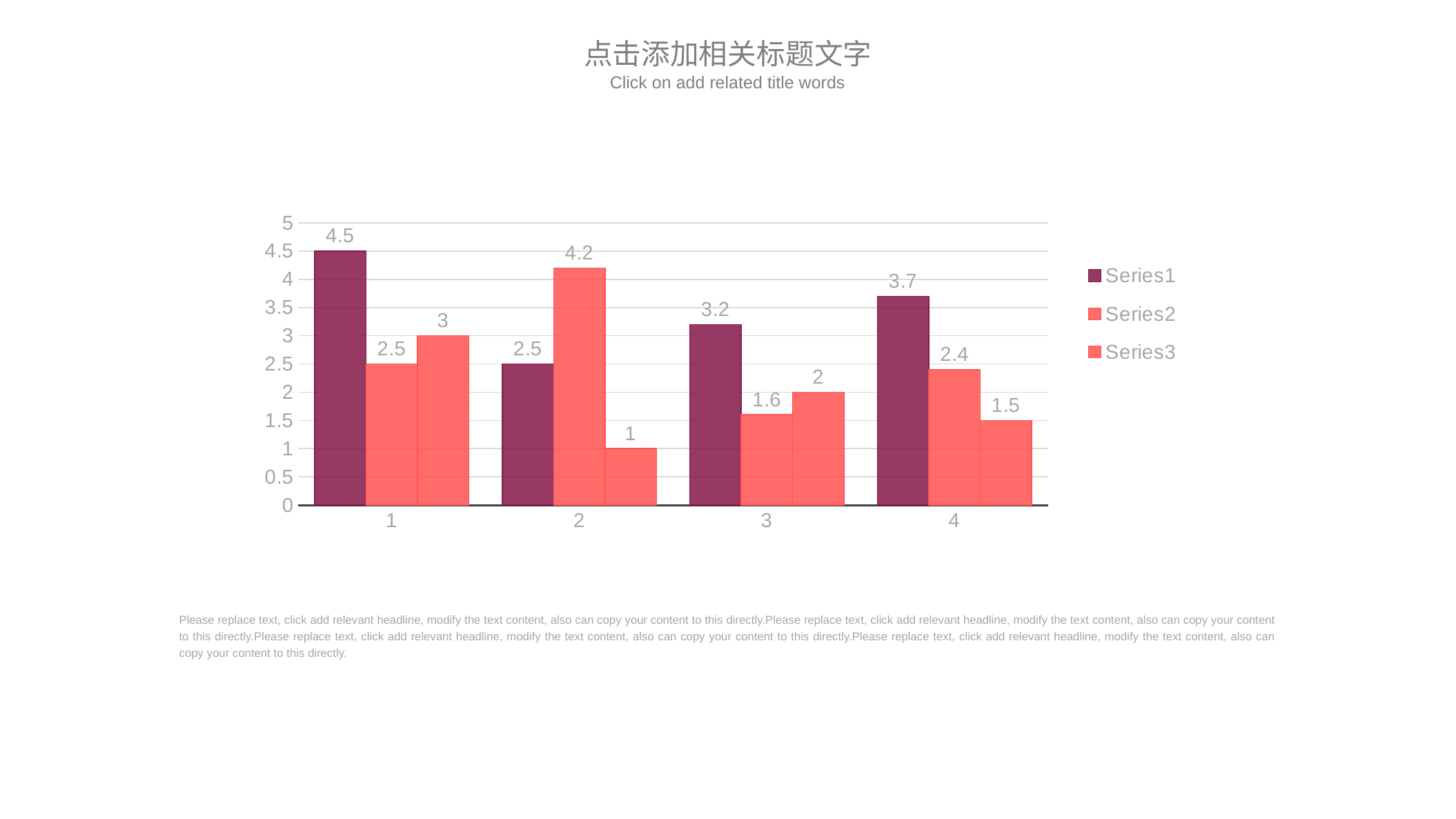
How many series does the legend list? 3 What is the difference between Series1 and Series2 for category 3? 1.6 Does Series3 rise or fall from category 1 to category 2? fall What kind of chart is shown on the slide? bar chart What is the value of Series3 for category 4? 1.5 For which category is Series1 highest? 1 Is the value of Series1 for category 4 greater or less than 3? greater What is the value of Series2 for category 2? 4.2 How many categories are shown on the x axis? 4 Which is larger for category 2: Series1 or Series2? Series2 What is the value of Series1 for category 1? 4.5 For which category is Series3 lowest? 2